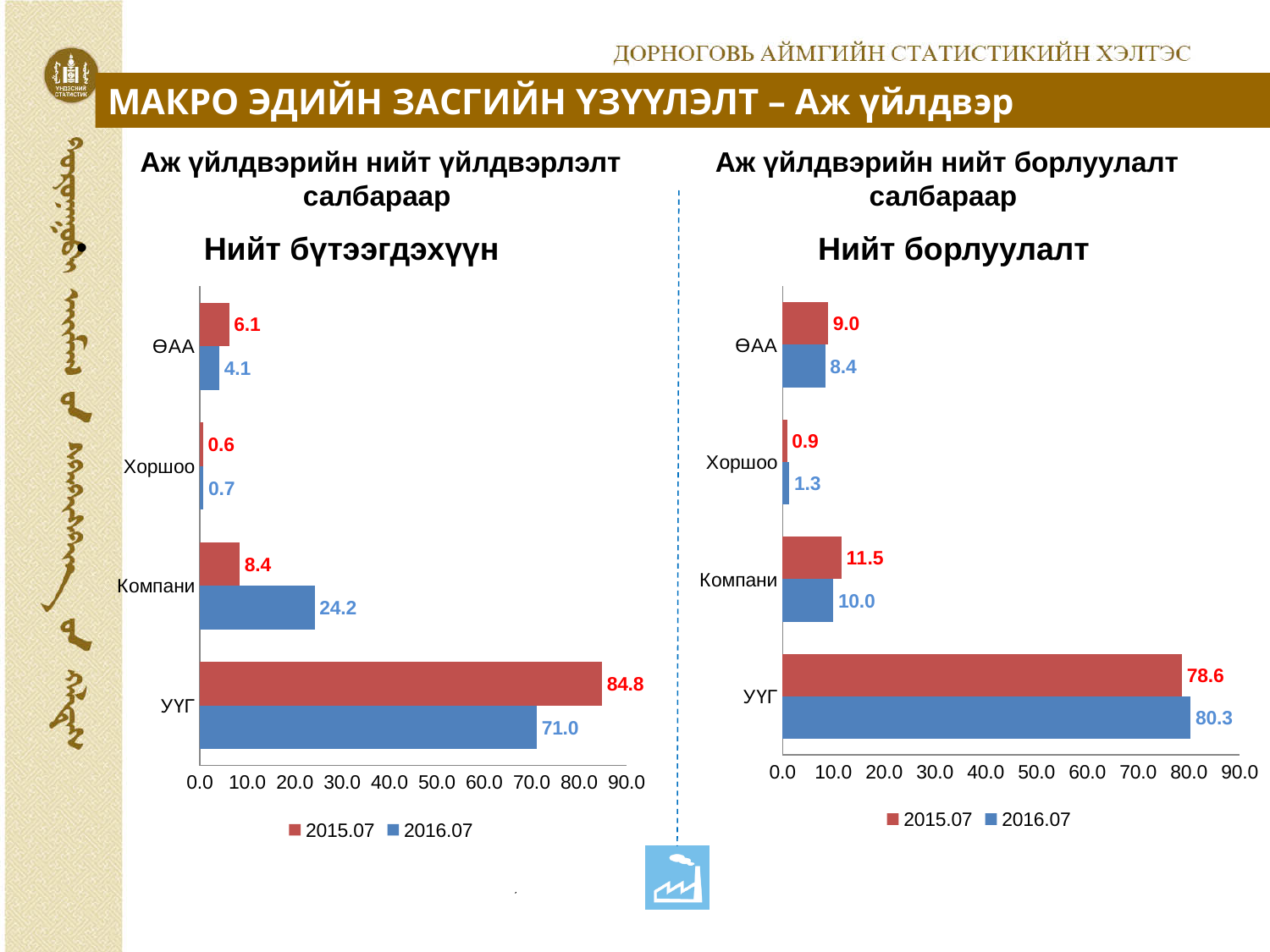
What type of chart is the 'Нийт борлуулалт' chart? Bar chart In the 'Нийт бүтээгдэхүүн' chart, what is the value for Компани in 2016.07? 24.2 In the 'Нийт бүтээгдэхүүн' chart, what is the difference between the 2015.07 and 2016.07 values for УҮГ? 13.8 How many categories are shown in the 'Нийт борлуулалт' chart? 4 In the 'Нийт бүтээгдэхүүн' chart, which is larger for Компани: the 2015.07 value or the 2016.07 value? 2016.07 In the 'Нийт борлуулалт' chart, what is the value for ӨАА in 2016.07? 8.4 In the 'Нийт борлуулалт' chart, which category has the lowest value for 2016.07? Хоршоо How many series does the legend of the 'Нийт бүтээгдэхүүн' chart list? 2 In the 'Нийт бүтээгдэхүүн' chart, what is the value for УҮГ in 2015.07? 84.8 In the 'Нийт борлуулалт' chart, what is the value for Хоршоо in 2015.07? 0.9 In the 'Нийт борлуулалт' chart, what is the difference between the 2016.07 and 2015.07 values for УҮГ? 1.7 In the 'Нийт бүтээгдэхүүн' chart, which category has the highest value for 2015.07? УҮГ